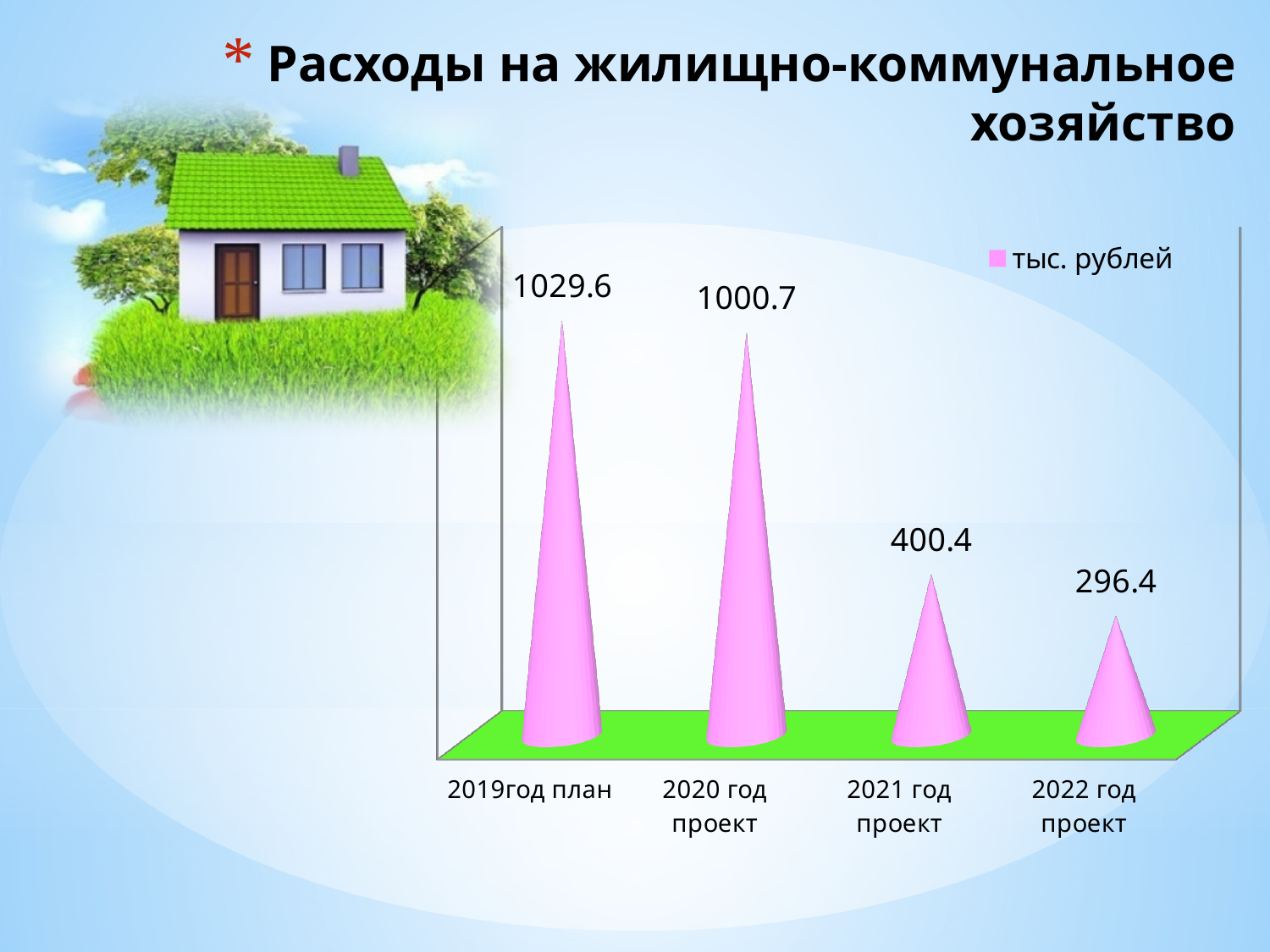
What is the difference between the values for 2019 год план and 2020 год проект? 28.9 What is the value for 2022 год проект? 296.4 Which category has the lowest value? 2022 год проект Which is larger, the value for 2020 год проект or the value for 2021 год проект? 2020 год проект What is the value for 2019 год план? 1029.6 What series name does the legend show? тыс. рублей What is the difference between the values for 2021 год проект and 2022 год проект? 104 Which category has the highest value? 2019 год план How many categories are shown on the chart? 4 What is the value for 2020 год проект? 1000.7 Do the values rise or fall from 2019 to 2022 along the x axis? fall What is the value for 2021 год проект? 400.4